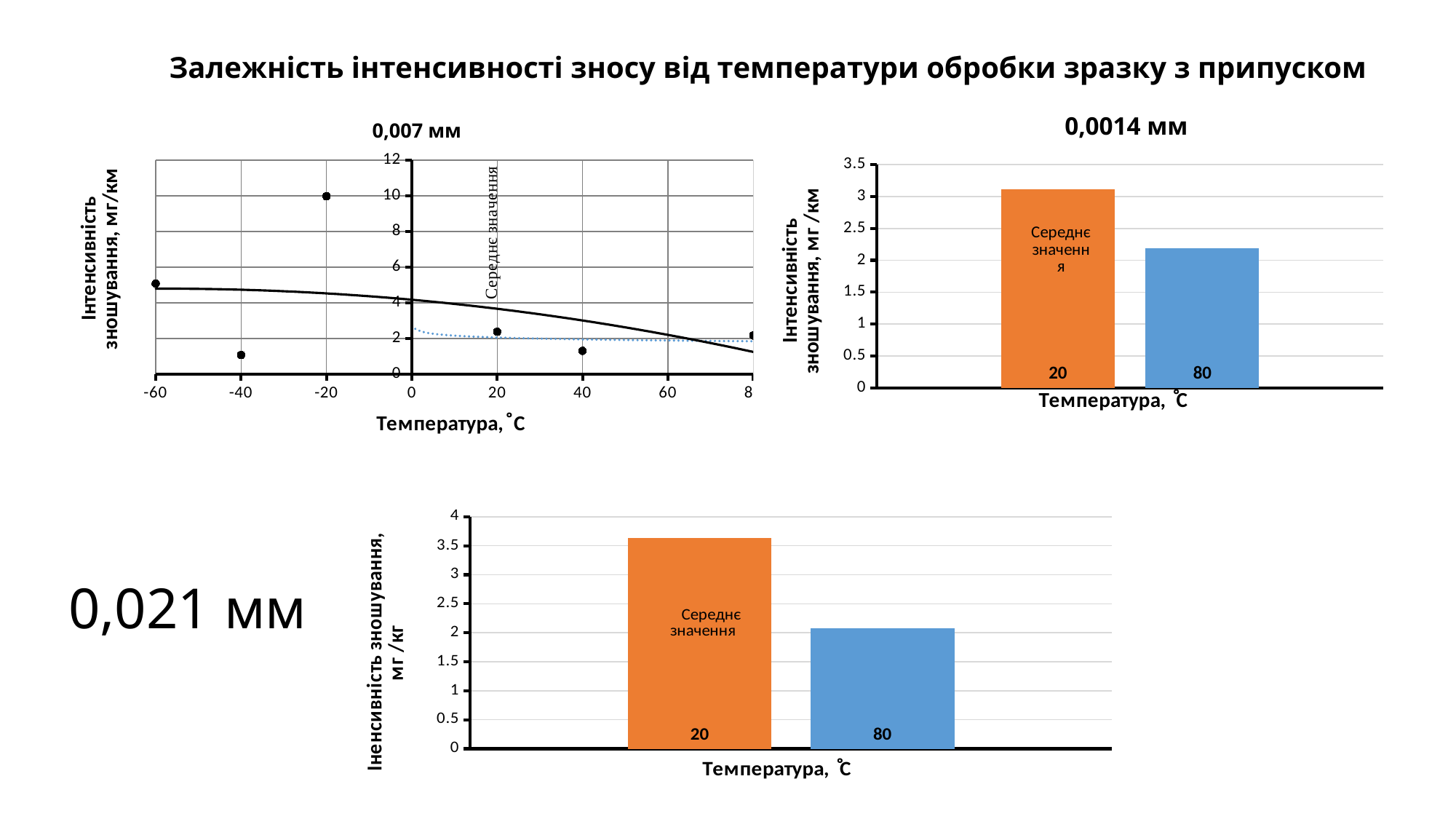
What is the x-axis title of the chart titled 0,0014 мм? Температура, ˚С In the chart titled 0,007 мм, is the value at -20 greater or less than 8? greater What kind of chart is the bottom chart (0,021 мм)? bar chart In the chart titled 0,0014 мм, how many bars are plotted? 2 In the chart titled 0,0014 мм, is the value for 80 greater or less than 2.5? less In the chart titled 0,0014 мм, which temperature has the higher bar, 20 or 80? 20 In the chart titled 0,007 мм, is the value at -40 greater or less than 2? less In the bottom chart (0,021 мм), which temperature has the lower bar? 80 In the chart titled 0,007 мм, how many data points are plotted? 6